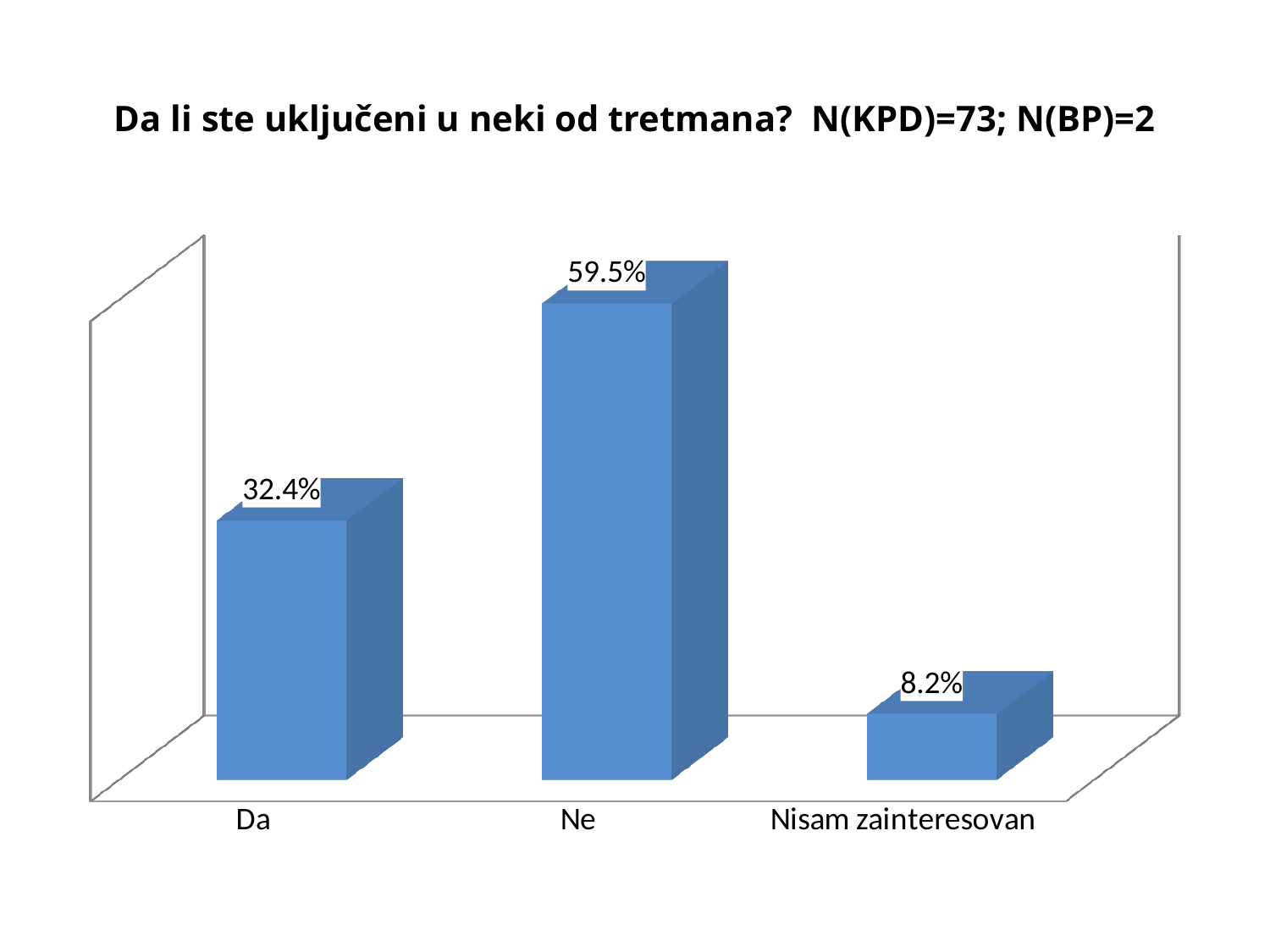
What is the difference between the values for "Da" and "Nisam zainteresovan"? 24.2% How many categories are shown on the chart? 3 What colour are the bars in the chart? Blue What is the value for "Ne"? 59.5% What is the value for "Da"? 32.4% What kind of chart is shown on the slide? Bar chart Which category has the highest value? Ne What is the difference between the values for "Ne" and "Da"? 27.1% What is the value for "Nisam zainteresovan"? 8.2% Which is larger, the value for "Da" or the value for "Nisam zainteresovan"? Da What is the title of the chart? Da li ste uključeni u neki od tretmana? N(KPD)=73; N(BP)=2 Which category has the lowest value? Nisam zainteresovan